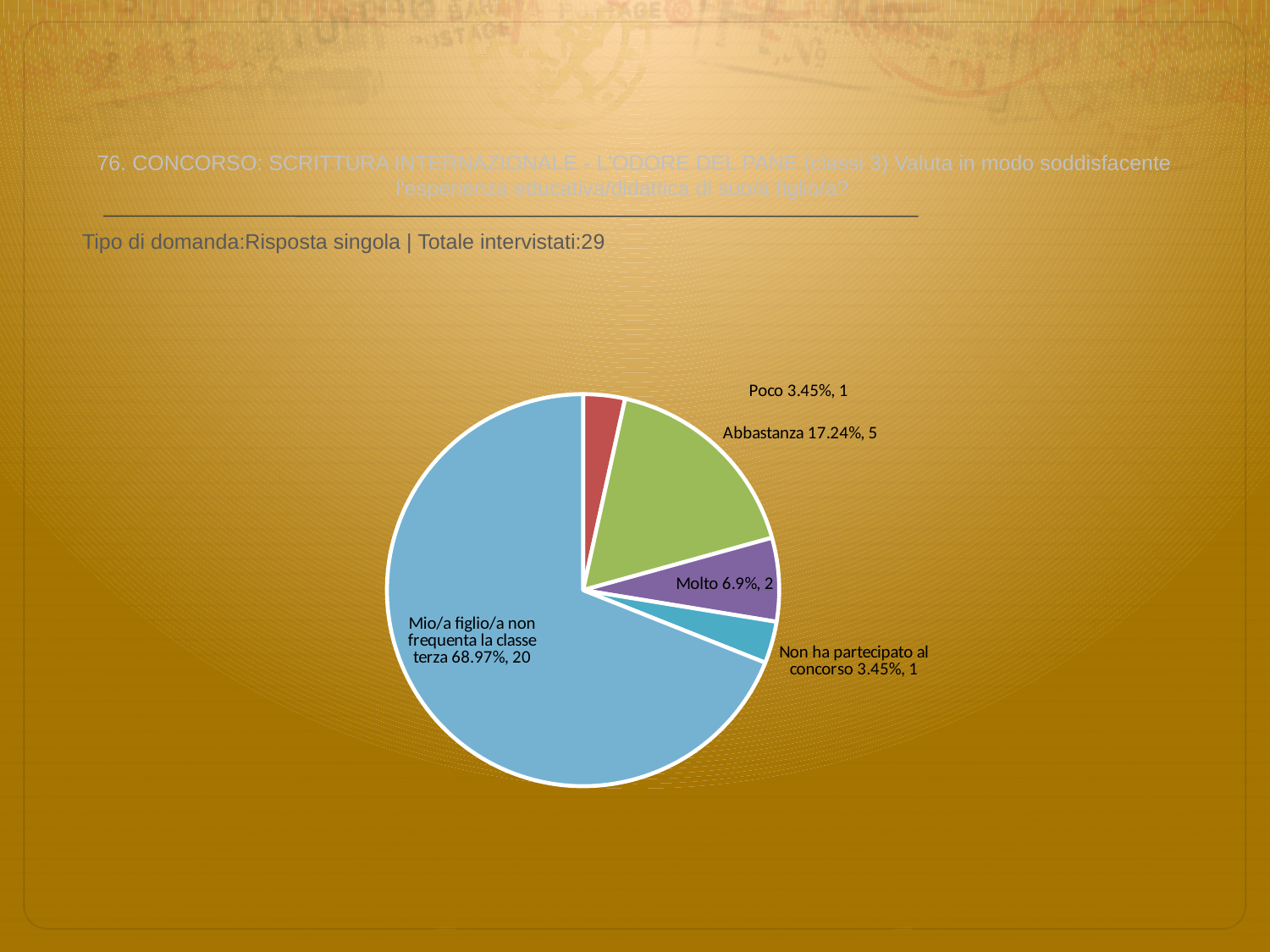
What percentage share does the "Non ha partecipato al concorso" slice represent? 3.45% What is the total number of respondents shown on the slide? 29 What percentage share does the "Abbastanza" slice represent? 17.24% What colour is the "Mio/a figlio/a non frequenta la classe terza" slice? Light blue Which is larger, the "Abbastanza" slice or the "Molto" slice? Abbastanza What kind of chart is shown on the slide? Pie chart How many respondents chose "Molto"? 2 What percentage share does the "Mio/a figlio/a non frequenta la classe terza" slice represent? 68.97% How many slices does the pie chart have? 5 How many respondents chose "Poco"? 1 What is the difference in number of respondents between "Abbastanza" and "Molto"? 3 Which category has the largest slice of the pie? Mio/a figlio/a non frequenta la classe terza